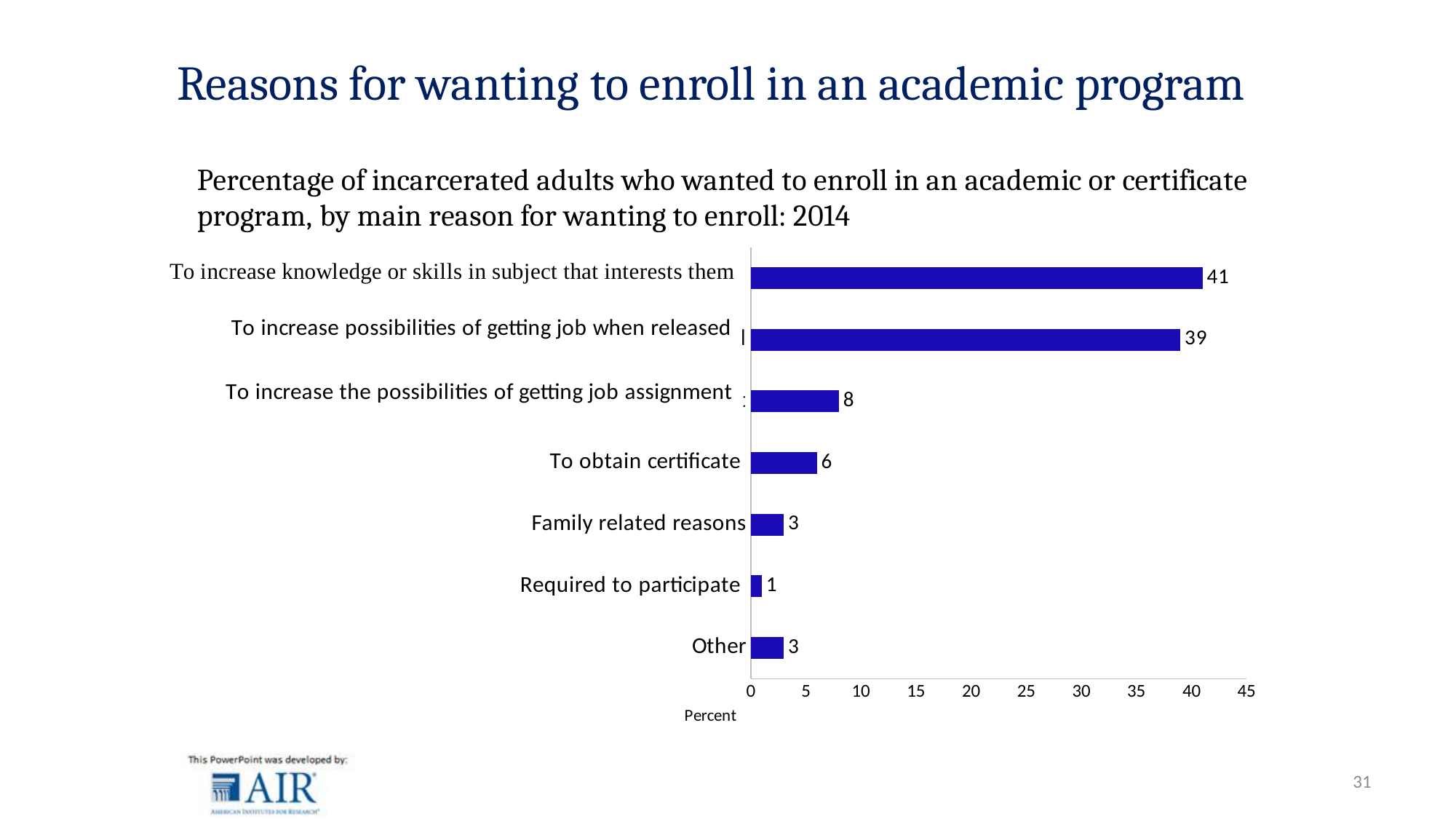
Which reason has the highest percentage? To increase knowledge or skills in subject that interests them What is the difference between the values for 'Family related reasons' and 'Required to participate'? 2 What is the value for 'Required to participate'? 1 Which is larger: the value for 'To increase the possibilities of getting job assignment' or the value for 'To obtain certificate'? To increase the possibilities of getting job assignment How many reason categories are shown in the chart? 7 What is the difference between the values for 'To increase knowledge or skills in subject that interests them' and 'To increase possibilities of getting job when released'? 2 What kind of chart is shown on the slide? Bar chart What percentage of incarcerated adults cited 'To increase knowledge or skills in subject that interests them' as their main reason for wanting to enroll? 41 Which reason has the lowest percentage? Required to participate What is the value for 'To obtain certificate'? 6 What is the label on the horizontal axis of the chart? Percent What is the value for 'To increase possibilities of getting job when released'? 39